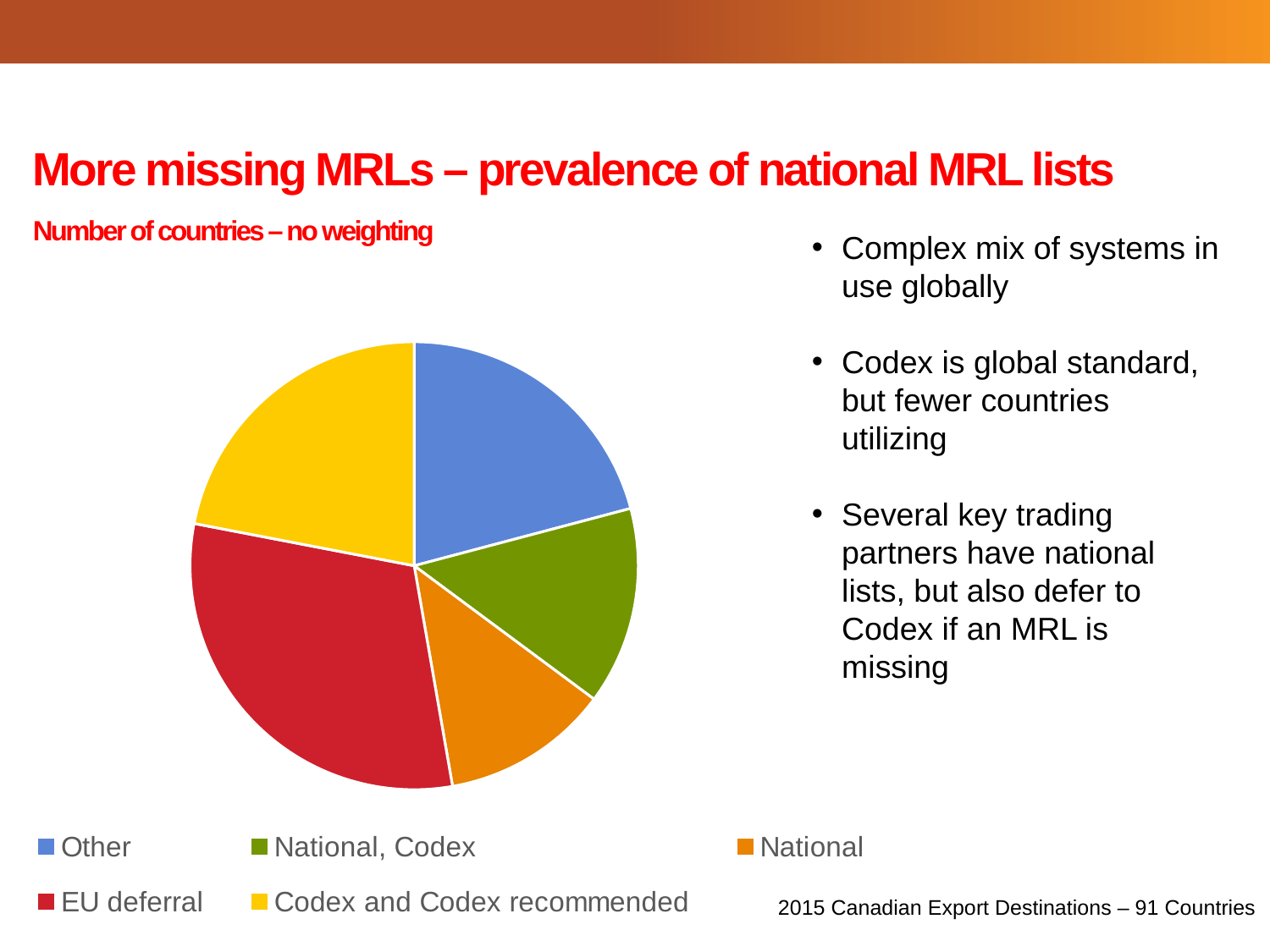
Which slice is larger, Other or National, Codex? Other Which slice is larger, EU deferral or Codex and Codex recommended? EU deferral Which slice is larger, EU deferral or National? EU deferral What is the subtitle shown above the pie chart? Number of countries – no weighting What colour represents EU deferral in the pie chart? red Which category has the largest slice of the pie chart? EU deferral What kind of chart is shown on the slide? pie chart How many slices does the pie chart have? 5 Which category has the smallest slice of the pie chart? National How many entries does the legend of the pie chart list? 5